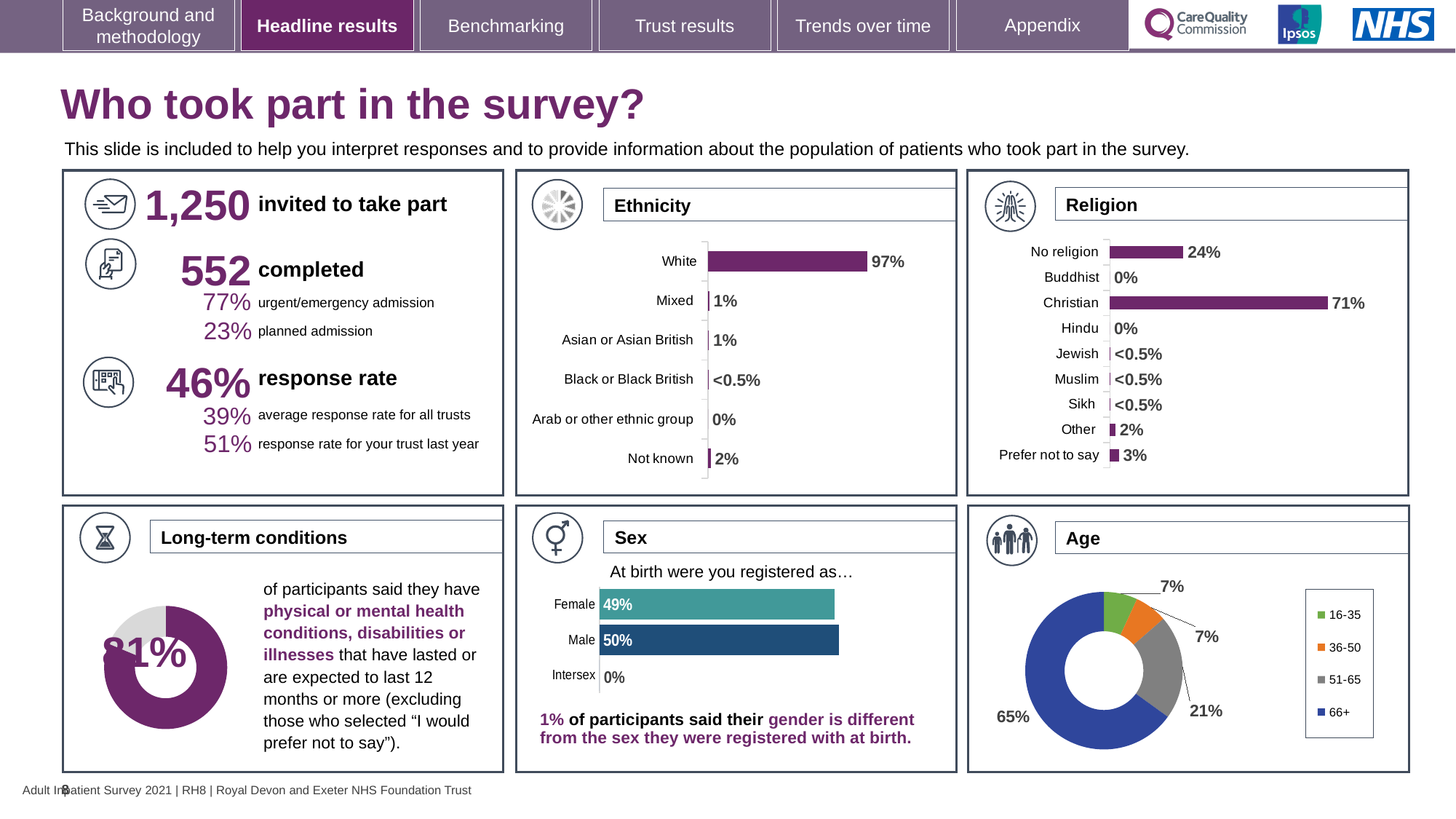
In the Ethnicity chart, what is the value for Not known? 2% In the Age chart, how many age groups does the legend list? 4 What kind of chart is used for the Age breakdown? Donut (pie) chart In the Religion chart, how many categories are listed? 9 In the Religion chart, what is the value for Prefer not to say? 3% In the Religion chart, which religion category has the highest value? Christian In the Sex chart, what percentage of participants were registered as Female at birth? 49% In the Sex chart, which is larger, the Female value or the Male value? Male In the Age chart, what share of participants were aged 66+? 65% In the Religion chart, what is the difference between the Christian and No religion values? 47% In the Ethnicity chart, what percentage of participants were White? 97% In the Ethnicity chart, how many ethnic categories are shown? 6